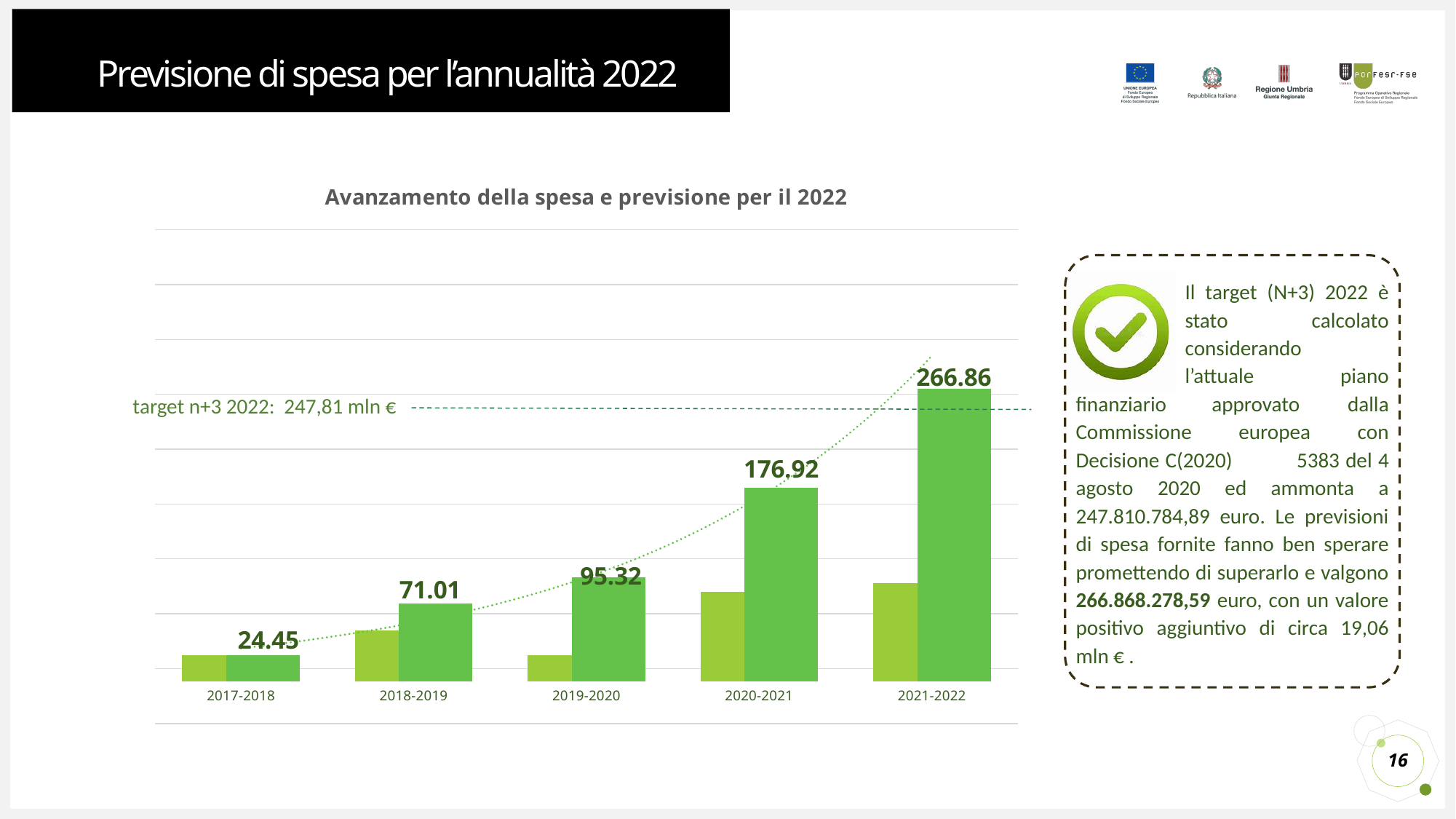
What is the labelled value for 2017-2018 in the chart? 24.45 Which period has the highest labelled value in the chart? 2021-2022 What is the labelled value for 2021-2022 in the chart 'Avanzamento della spesa e previsione per il 2022'? 266.86 What is the difference between the labelled values for 2021-2022 and 2020-2021? 89.94 Do the labelled values rise or fall from 2017-2018 to 2021-2022? Rise Which is larger, the labelled value for 2019-2020 or for 2018-2019? 2019-2020 What is the labelled value for 2019-2020 in the chart? 95.32 How many periods are shown on the x axis of the chart? 5 What is the difference between the labelled values for 2018-2019 and 2017-2018? 46.56 What kind of chart is shown on the slide? Bar chart What is the labelled value for 2020-2021 in the chart? 176.92 Which period has the lowest labelled value in the chart? 2017-2018